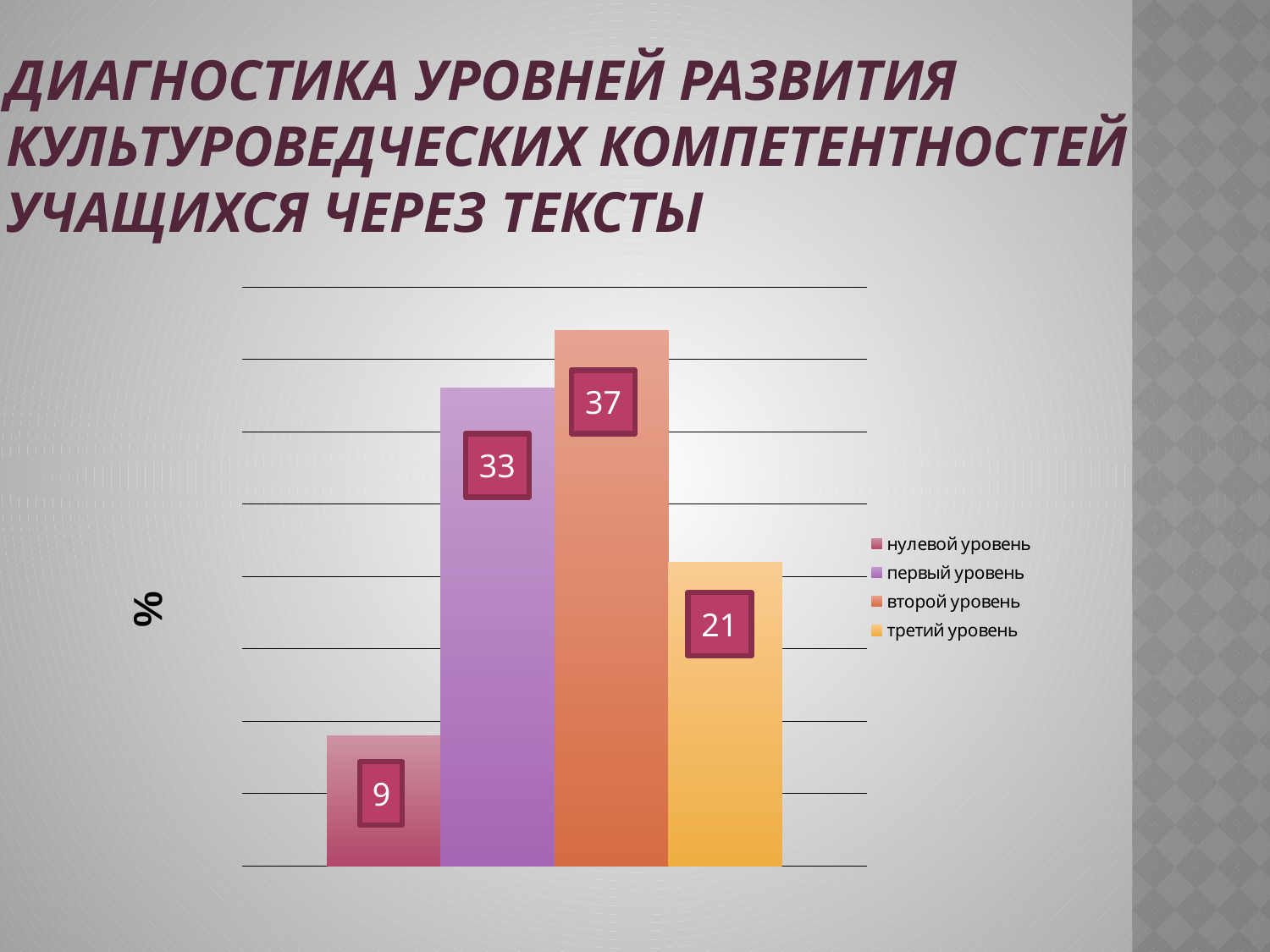
What is the value for нулевой уровень? 9 What is the value for третий уровень? 21 What is the value for второй уровень? 37 Which level has the highest value? второй уровень What is the difference between the values for второй уровень and первый уровень? 4 What is the value for первый уровень? 33 Which is larger, the value for первый уровень or the value for третий уровень? первый уровень What is the difference between the values for третий уровень and нулевой уровень? 12 Which level has the lowest value? нулевой уровень What kind of chart is shown on the slide? bar chart How many entries does the legend list? 4 How many bars are plotted in the chart? 4